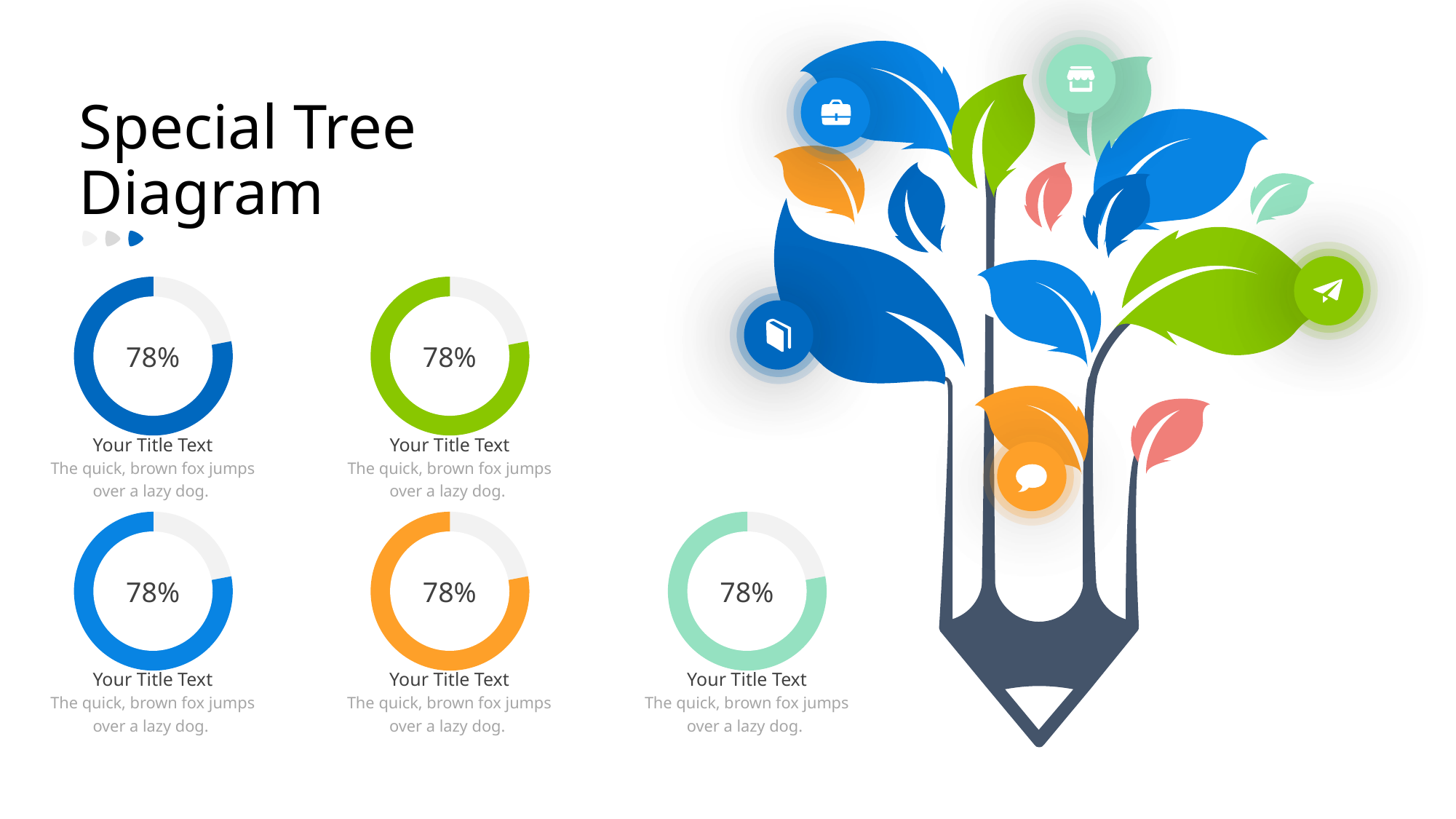
What percentage is shown in the mint green donut chart at the bottom right of the chart area? 78% What value is printed inside the orange donut chart at the bottom middle of the slide? 78% What share of the mint green donut chart is filled with colour? 78% What value is shown in the centre of the dark blue donut chart at the top left of the slide? 78% What value does the light blue donut chart at the bottom left of the slide show? 78% Do the dark blue donut chart and the green donut chart show the same value? Yes, both show 78% What colour is the filled portion of the donut chart at the bottom middle of the slide? Orange How many donut charts are on the slide? 5 What percentage does the green donut chart at the top middle of the slide display? 78% Is the value shown in the orange donut chart greater or less than 50%? greater What kind of chart is used for each of the five percentage figures on the slide? Donut chart What is the title of the slide containing the donut charts? Special Tree Diagram